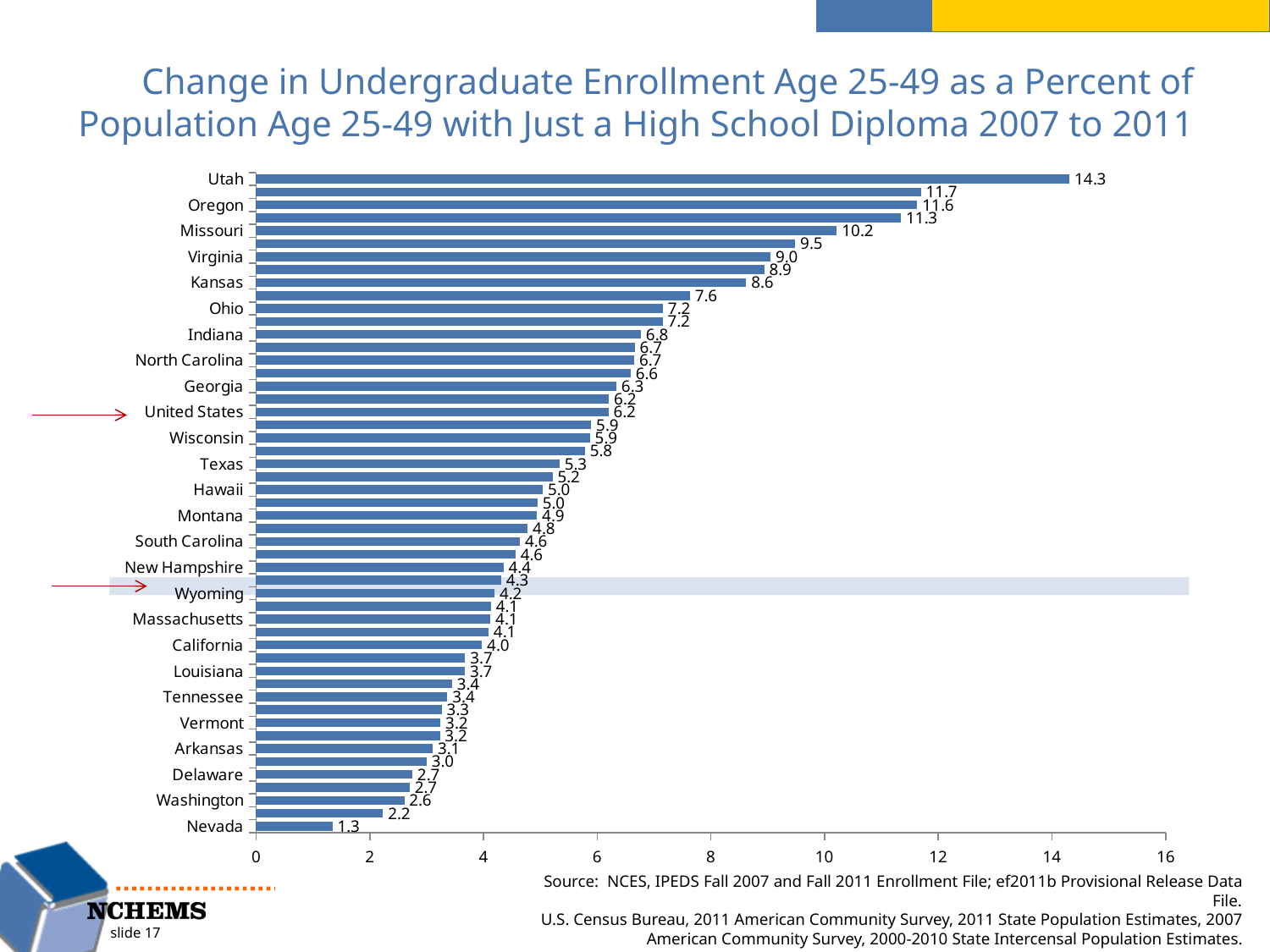
What is the value shown for Wyoming? 4.2 Do the bar values increase or decrease going from the top of the chart to the bottom? Decrease What is the value shown for Utah? 14.3 What is the value shown for the United States? 6.2 Which has a larger value, Utah or Missouri? Utah What is the value shown for Nevada? 1.3 What is the maximum value shown on the horizontal axis? 16 What is the difference between the values for Utah and Nevada? 13.0 Is the value for Kansas greater or less than 8? greater What type of chart is shown on the slide? Bar chart Which state has the highest value in the chart? Utah Which state has the lowest value in the chart? Nevada